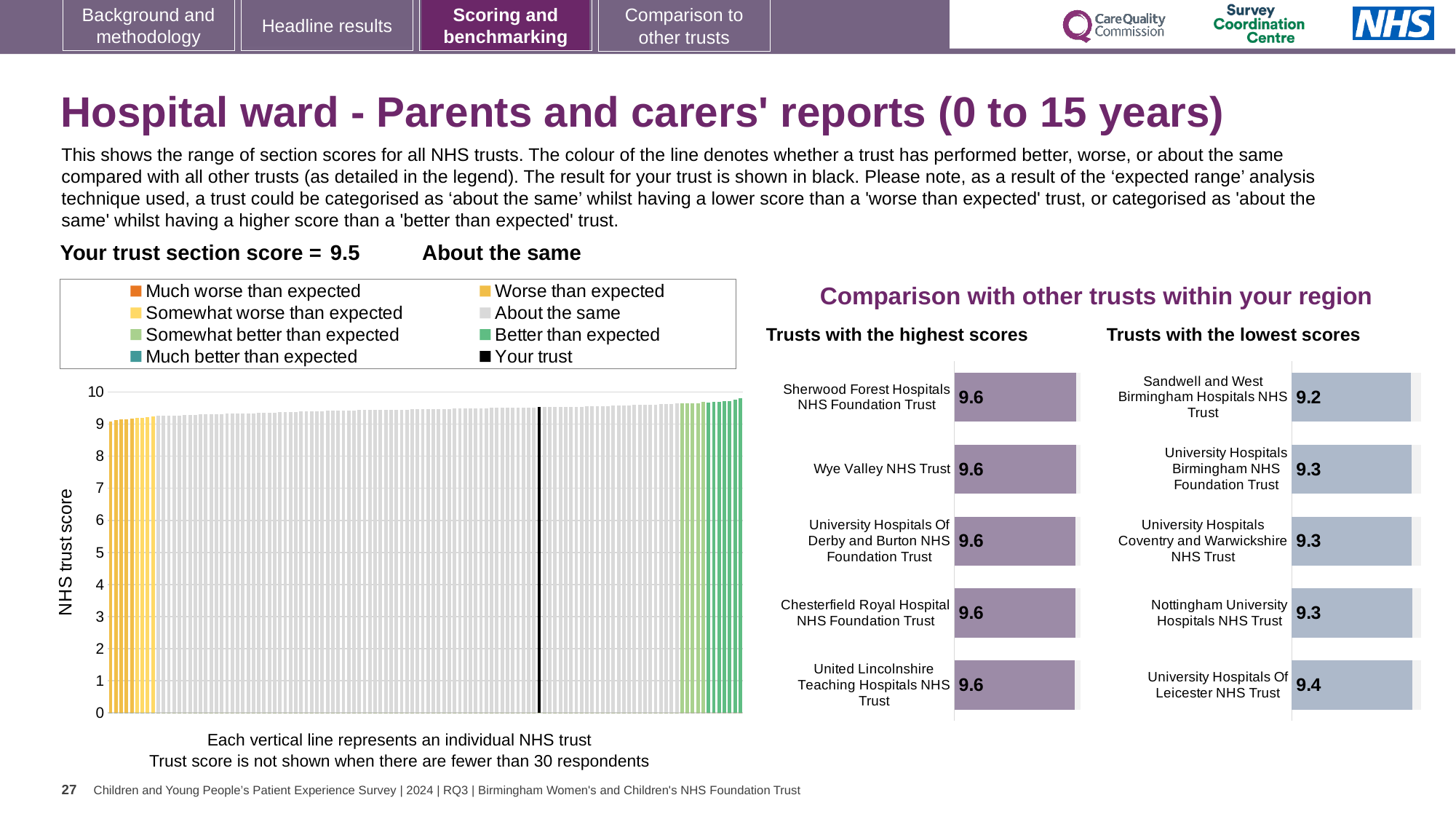
How many trusts are shown in the 'Trusts with the highest scores' chart? 5 In the 'Trusts with the lowest scores' chart, which trust has the lowest score? Sandwell and West Birmingham Hospitals NHS Trust In the main chart on the left, do the trust scores rise or fall from left to right along the x axis? rise In the main chart on the left, is the value for the lowest-scoring trust greater or less than 8? greater In the 'Trusts with the lowest scores' chart, which trust has the highest score? University Hospitals Of Leicester NHS Trust What is the difference between the score of Sherwood Forest Hospitals NHS Foundation Trust in the 'Trusts with the highest scores' chart and your trust section score? 0.1 In the 'Trusts with the lowest scores' chart, what is the score for Sandwell and West Birmingham Hospitals NHS Trust? 9.2 How many entries does the legend of the main chart on the left list? 8 In the 'Trusts with the highest scores' chart, what is the score for Wye Valley NHS Trust? 9.6 In the 'Trusts with the lowest scores' chart, which has the larger score: Nottingham University Hospitals NHS Trust or Sandwell and West Birmingham Hospitals NHS Trust? Nottingham University Hospitals NHS Trust In the 'Trusts with the lowest scores' chart, what is the score for University Hospitals Of Leicester NHS Trust? 9.4 In the 'Trusts with the lowest scores' chart, what is the difference between the scores of University Hospitals Of Leicester NHS Trust and Sandwell and West Birmingham Hospitals NHS Trust? 0.2